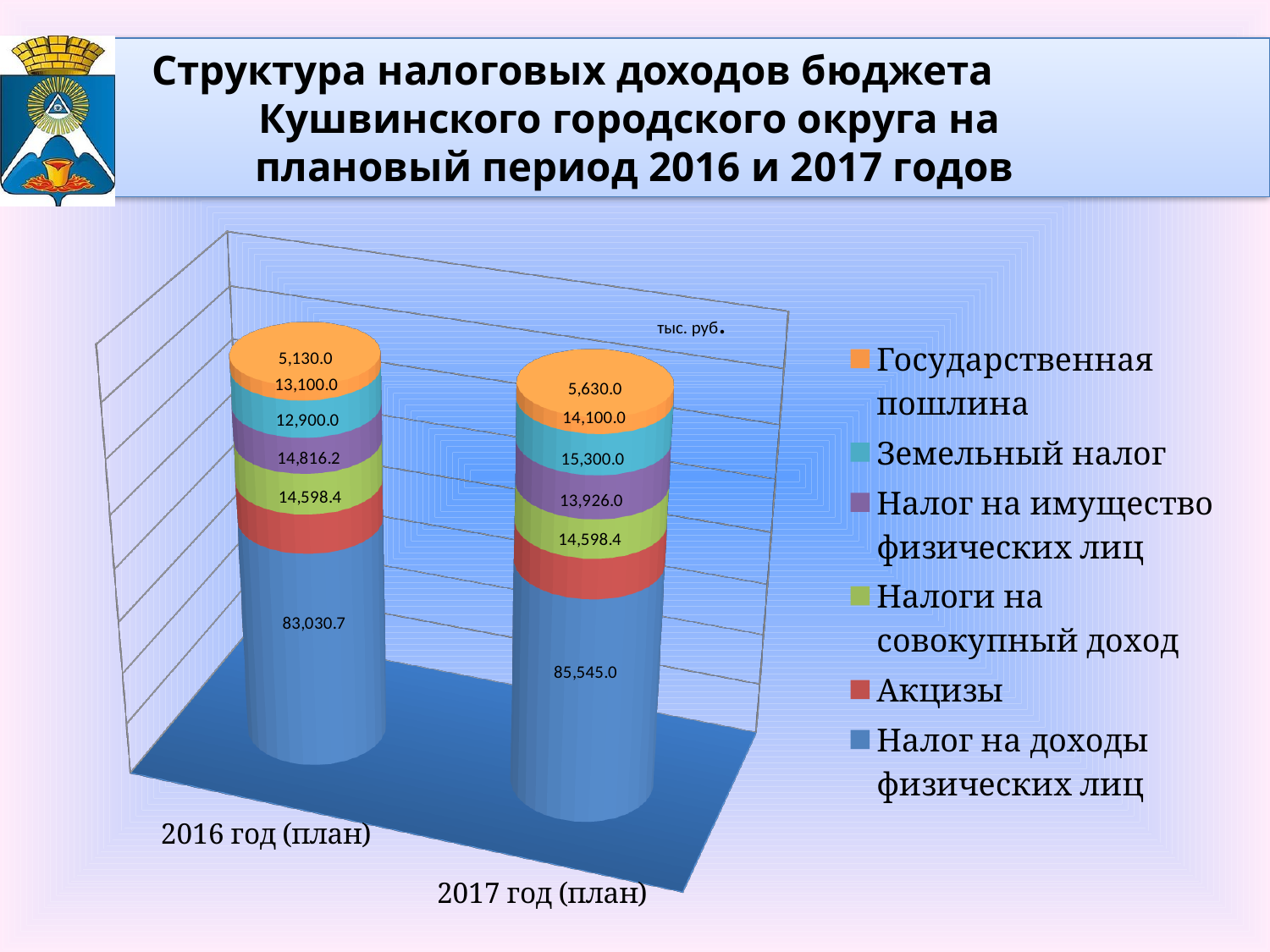
What is the value of Налог на доходы физических лиц for 2017 год (план)? 85,545.0 Which is larger: Земельный налог in 2016 год (план) or in 2017 год (план)? 2017 год (план) By how much does Налог на доходы физических лиц in 2017 год (план) exceed its value in 2016 год (план)? 2,514.3 Which series has the smallest value in the 2016 год (план) bar? Государственная пошлина What is the value of Государственная пошлина for 2017 год (план)? 5,630.0 What is the total of the 2016 год (план) stacked bar? 143,575.3 What is the value of Налог на доходы физических лиц for 2016 год (план)? 83,030.7 How many series does the legend list? 6 What is the value of Налоги на совокупный доход for 2016 год (план)? 14,816.2 Which series has the largest value in the 2017 год (план) bar? Налог на доходы физических лиц What kind of chart is shown on the slide? stacked bar chart How many categories (years) are plotted on the x axis? 2